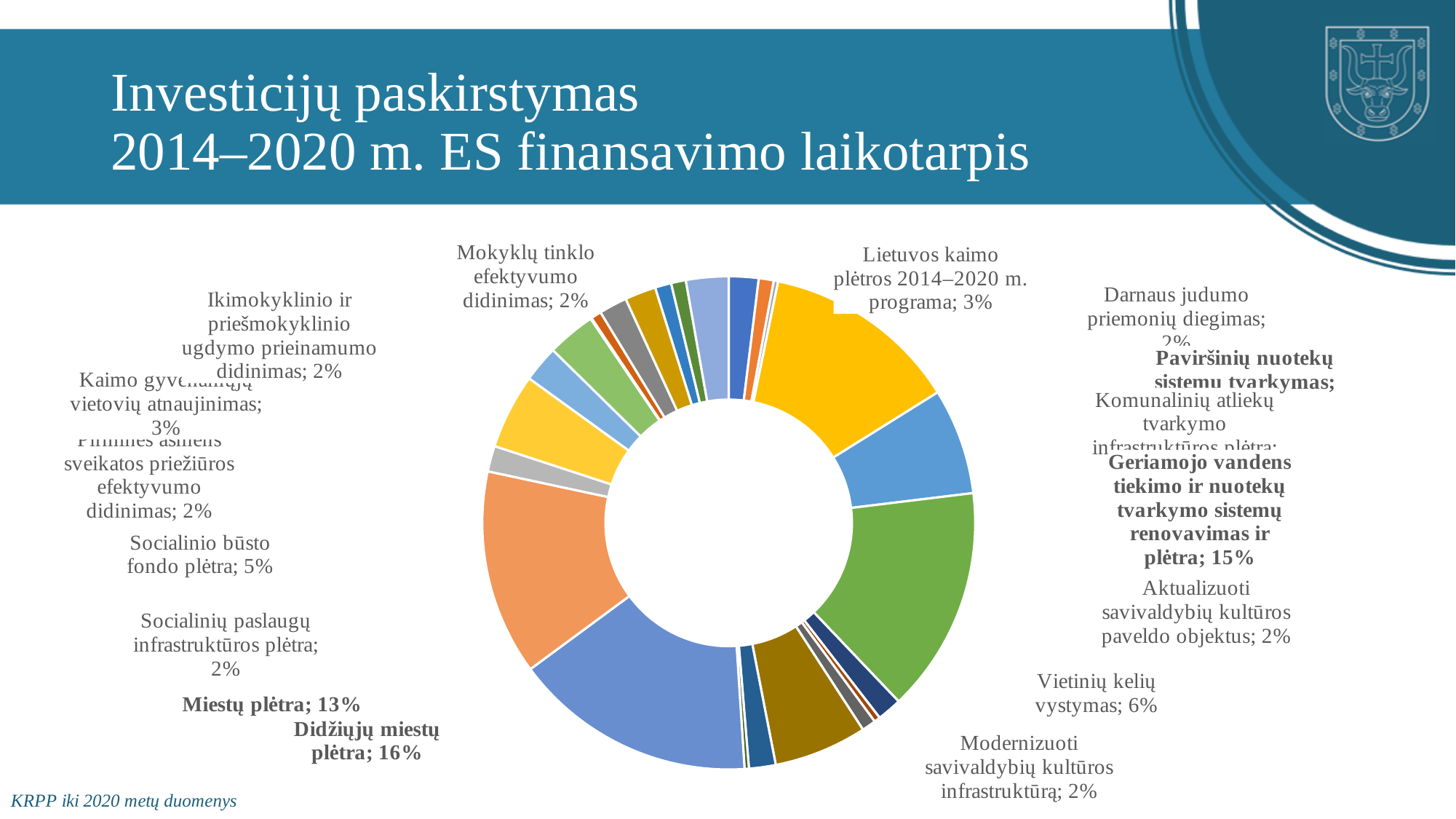
Which is larger, Vietinių kelių vystymas or Socialinio būsto fondo plėtra? Vietinių kelių vystymas What kind of chart is shown on the slide? Pie (doughnut) chart What is the difference in percentage points between Didžiųjų miestų plėtra and Miestų plėtra? 3% What percentage is shown for Lietuvos kaimo plėtros 2014–2020 m. programa? 3% What percentage is shown for Geriamojo vandens tiekimo ir nuotekų tvarkymo sistemų renovavimas ir plėtra? 15% What share is labelled for Socialinio būsto fondo plėtra? 5% What is the difference between Geriamojo vandens tiekimo ir nuotekų tvarkymo sistemų renovavimas ir plėtra and Vietinių kelių vystymas? 9% What is the title of the slide? Investicijų paskirstymas 2014–2020 m. ES finansavimo laikotarpis Which is larger, Didžiųjų miestų plėtra or Miestų plėtra? Didžiųjų miestų plėtra What share of investments goes to Didžiųjų miestų plėtra? 16% What is the value for Miestų plėtra? 13% What is the value for Vietinių kelių vystymas? 6%